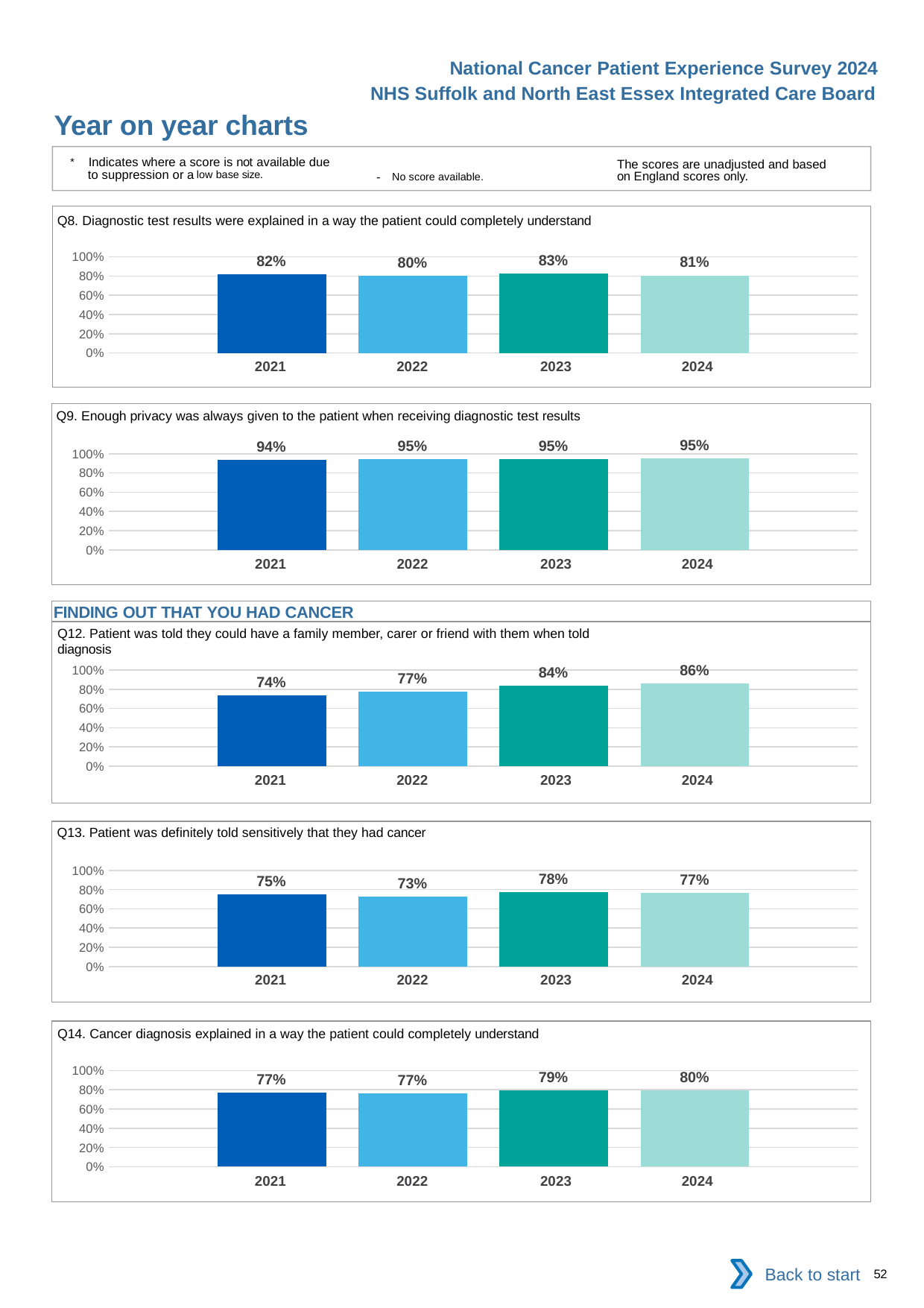
In the Q13 chart, which is larger, the value for 2023 or the value for 2024? 2023 In the Q12 chart, do the values rise or fall from 2021 to 2024? rise In the Q14 chart, what is the value for 2024? 80% In the Q14 chart, what is the difference between the 2023 value and the 2021 value? 2% In the Q13 chart, what is the value for 2022? 73% In the Q12 chart, which year has the highest value? 2024 In the Q9 chart, what is the value for 2021? 94% In the Q8 chart, what is the value for 2023? 83% In the Q12 chart, what is the difference between the 2024 value and the 2021 value? 12% In the Q9 chart, how many years are plotted? 4 What kind of chart is the Q14 chart? bar chart In the Q8 chart, which year has the lowest value? 2022